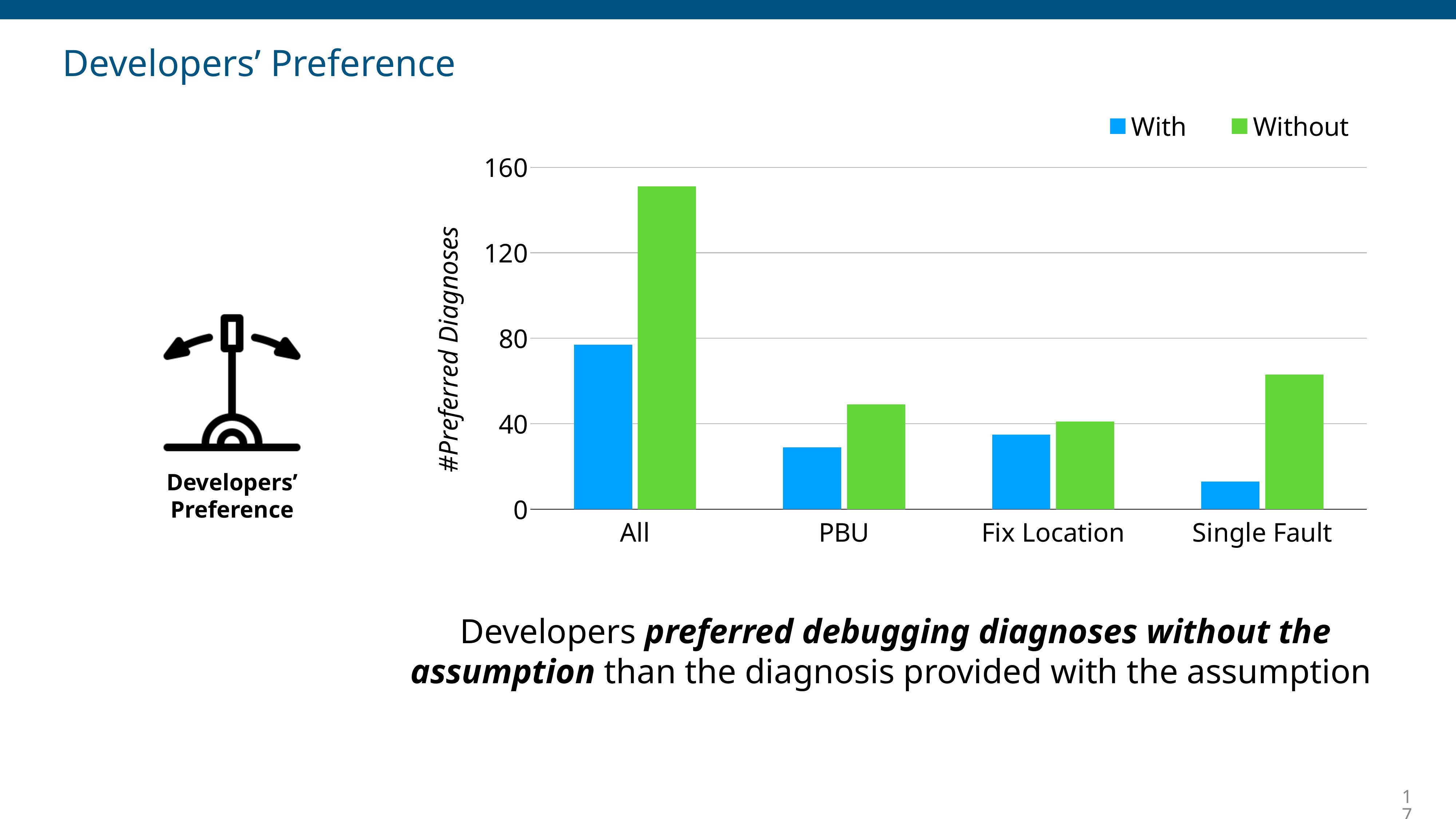
Is the With value for Single Fault greater or less than 40? less How many series does the legend list? 2 Is the Without value for All greater or less than 120? greater Is the Without value for Single Fault greater or less than 40? greater What is the label on the y axis of the chart? #Preferred Diagnoses For Single Fault, which is larger: the With value or the Without value? Without For All, which is larger: the With value or the Without value? Without What kind of chart is shown on the slide? bar chart Which category has the lowest value for the With series? Single Fault Which category has the highest value for the Without series? All How many categories are shown on the x axis? 4